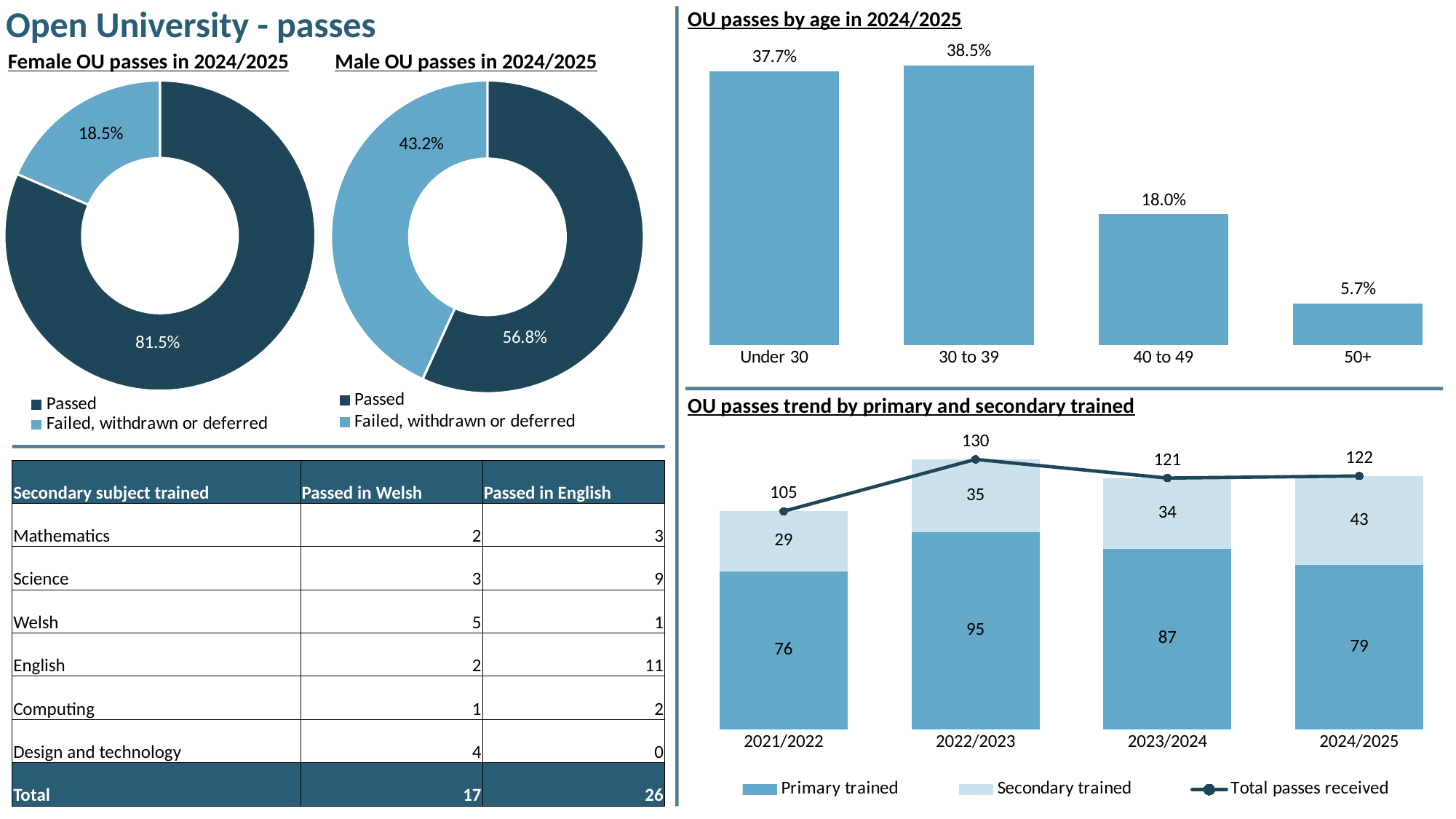
In the 'OU passes by age in 2024/2025' chart, how many age categories are shown? 4 In the 'Female OU passes in 2024/2025' chart, what kind of chart is shown? Pie chart (doughnut) In the 'Female OU passes in 2024/2025' chart, what share of the pie is 'Passed'? 81.5% In the 'Male OU passes in 2024/2025' chart, what share of the pie is 'Failed, withdrawn or deferred'? 43.2% In the 'OU passes trend by primary and secondary trained' chart, what is the total of the stacked bar for 2024/2025? 122 In the 'OU passes trend by primary and secondary trained' chart, which year has the highest 'Total passes received'? 2022/2023 In the 'OU passes trend by primary and secondary trained' chart, what is the 'Primary trained' value for 2022/2023? 95 In the 'OU passes by age in 2024/2025' chart, which age group has the lowest value? 50+ In the 'OU passes trend by primary and secondary trained' chart, is the 'Secondary trained' value for 2021/2022 larger or smaller than for 2024/2025? Smaller In the 'OU passes by age in 2024/2025' chart, what is the value for '30 to 39'? 38.5% In the 'OU passes by age in 2024/2025' chart, what is the difference between 'Under 30' and '40 to 49'? 19.7% In the 'OU passes trend by primary and secondary trained' chart, how many series does the legend list? 3